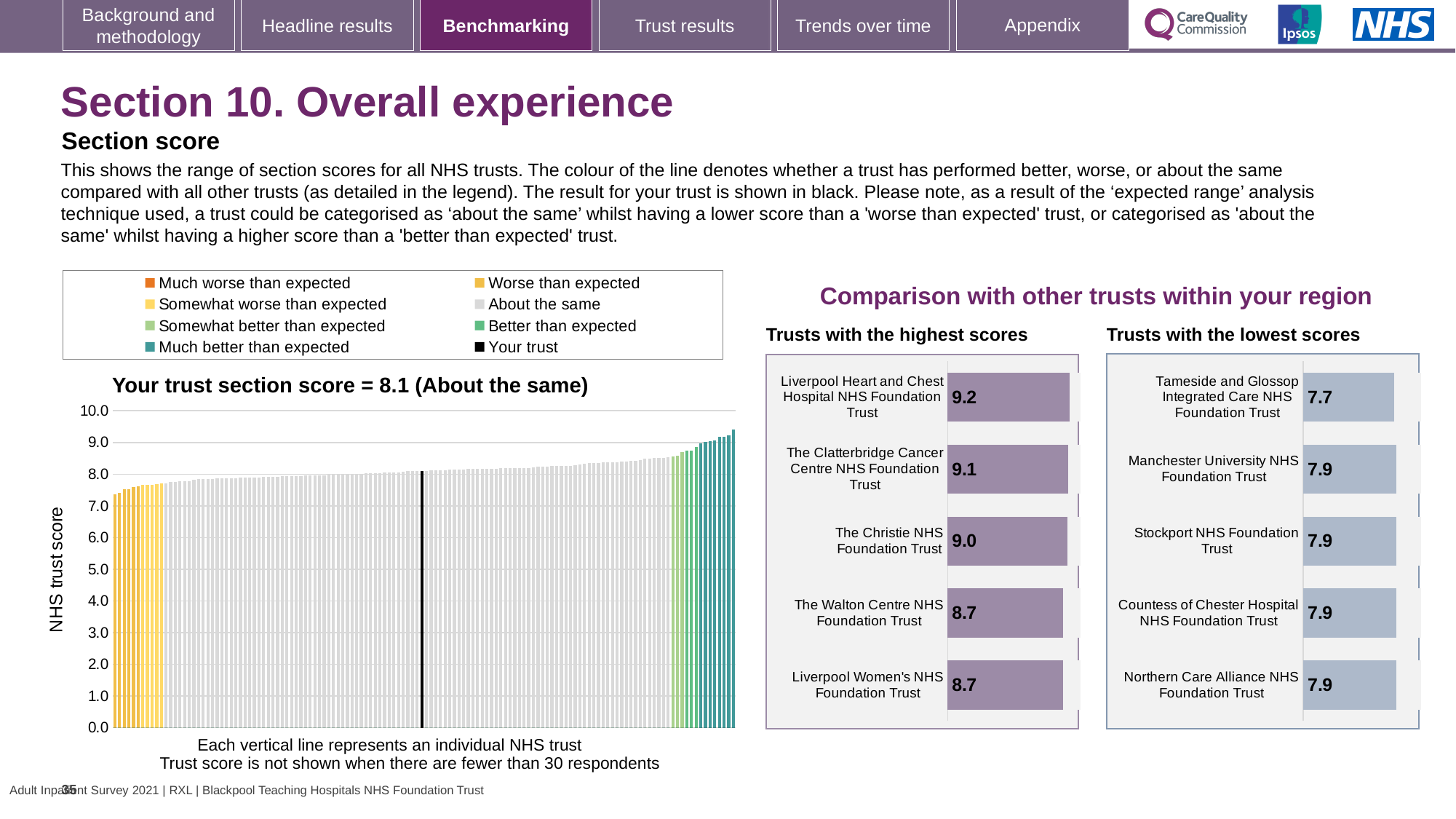
How many trusts are shown in the 'Trusts with the lowest scores' chart? 5 What kind of chart is the 'Your trust section score' chart? bar chart In the 'Your trust section score' chart, is the value of the leftmost (lowest) bar greater or less than 8.0? less In the 'Your trust section score' chart, what is the section score for your trust? 8.1 In the 'Your trust section score' chart, do the trust scores rise or fall from left to right along the x axis? rise How many entries does the legend above the 'Your trust section score' chart list? 8 In the 'Trusts with the lowest scores' chart, which trust has the lowest score? Tameside and Glossop Integrated Care NHS Foundation Trust In the 'Your trust section score' chart, is the value of the rightmost (highest) bar greater or less than 9.0? greater In the 'Trusts with the lowest scores' chart, what is the score for Stockport NHS Foundation Trust? 7.9 In the 'Trusts with the highest scores' chart, which trust has the highest score? Liverpool Heart and Chest Hospital NHS Foundation Trust In the 'Trusts with the highest scores' chart, what is the difference between the scores of Liverpool Heart and Chest Hospital NHS Foundation Trust and The Walton Centre NHS Foundation Trust? 0.5 In the 'Trusts with the highest scores' chart, what is the score for The Christie NHS Foundation Trust? 9.0